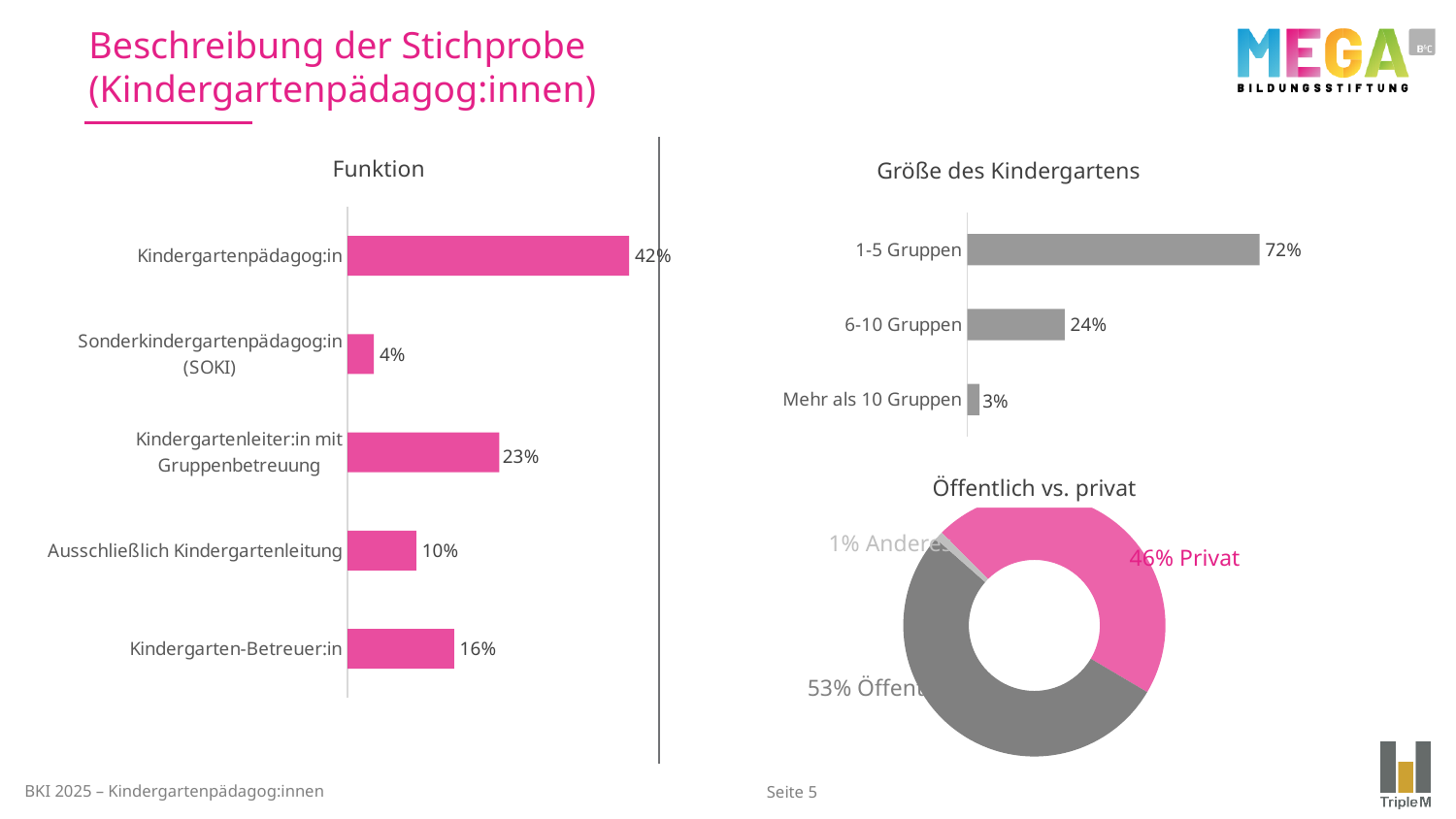
In the 'Öffentlich vs. privat' chart, what share is Anderes? 1% In the 'Größe des Kindergartens' chart, which category has the highest value? 1-5 Gruppen In the 'Funktion' chart, how many categories are shown? 5 In the 'Größe des Kindergartens' chart, what is the difference between 1-5 Gruppen and 6-10 Gruppen? 48% In the 'Funktion' chart, what is the difference between Kindergarten-Betreuer:in and Ausschließlich Kindergartenleitung? 6% In the 'Öffentlich vs. privat' chart, what share is Privat? 46% In the 'Funktion' chart, which is larger: Kindergarten-Betreuer:in or Ausschließlich Kindergartenleitung? Kindergarten-Betreuer:in In the 'Funktion' chart, what is the value for Kindergartenleiter:in mit Gruppenbetreuung? 23% In the 'Funktion' chart, which category has the lowest value? Sonderkindergartenpädagog:in (SOKI) In the 'Größe des Kindergartens' chart, what is the value for 6-10 Gruppen? 24% What kind of chart is 'Öffentlich vs. privat'? Donut (pie) chart In the 'Funktion' chart, what is the value for Kindergartenpädagog:in? 42%